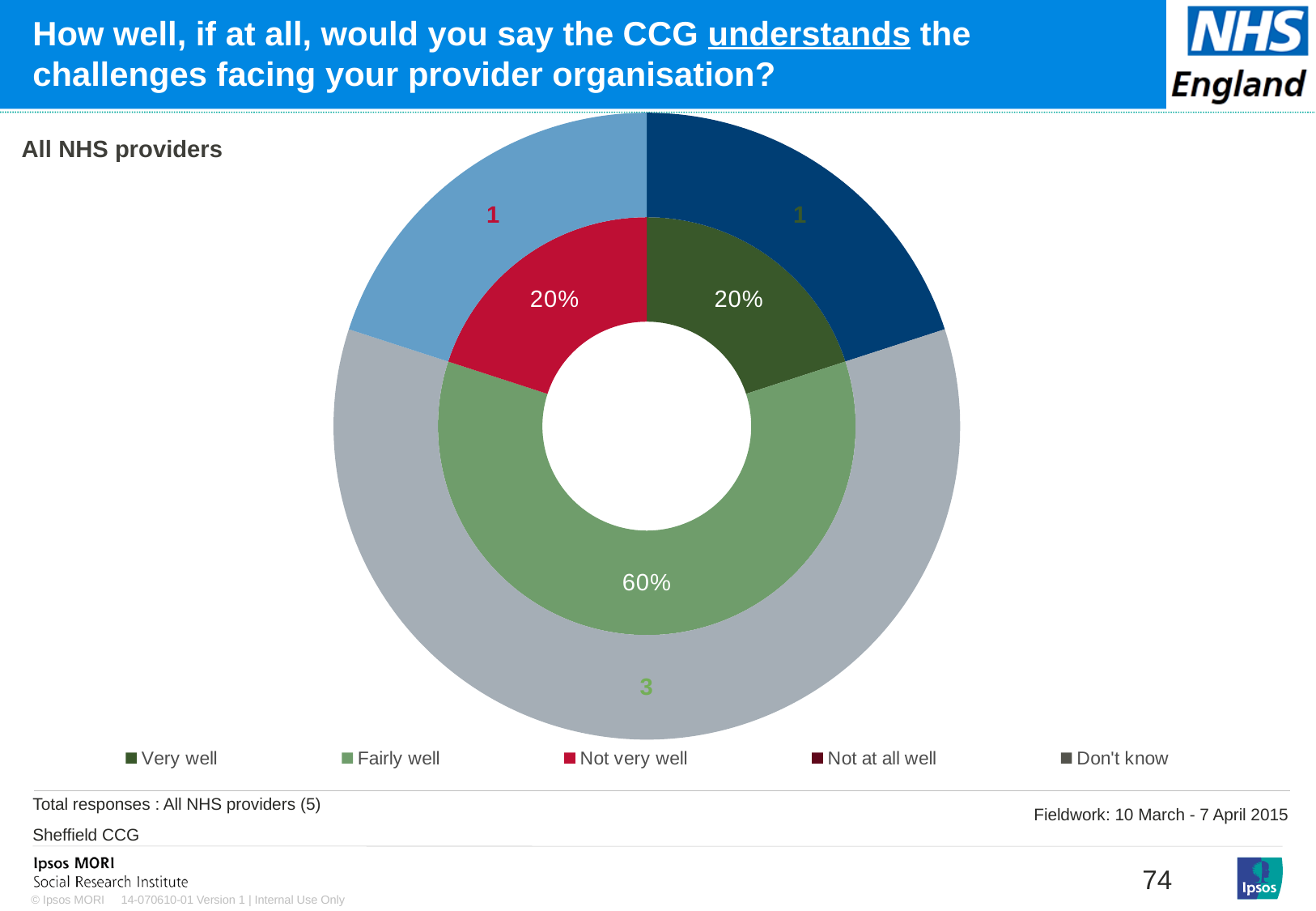
What percentage of respondents answered 'Not very well'? 20% What percentage of respondents said the CCG understands the challenges 'Fairly well'? 60% What is the difference in percentage points between 'Fairly well' and 'Very well'? 40 percentage points What is the total number of responses stated below the chart for All NHS providers? 5 How many response categories does the legend list? 5 How many response categories have a percentage label shown on the chart? 3 What kind of chart is shown on the slide? doughnut chart How many respondents does the outer ring show for 'Fairly well'? 3 What is the label shown at the top left of the chart area describing the respondent group? All NHS providers Which is larger, the share for 'Fairly well' or the share for 'Not very well'? Fairly well Which response category has the largest share of the chart? Fairly well What percentage of respondents answered 'Very well'? 20%